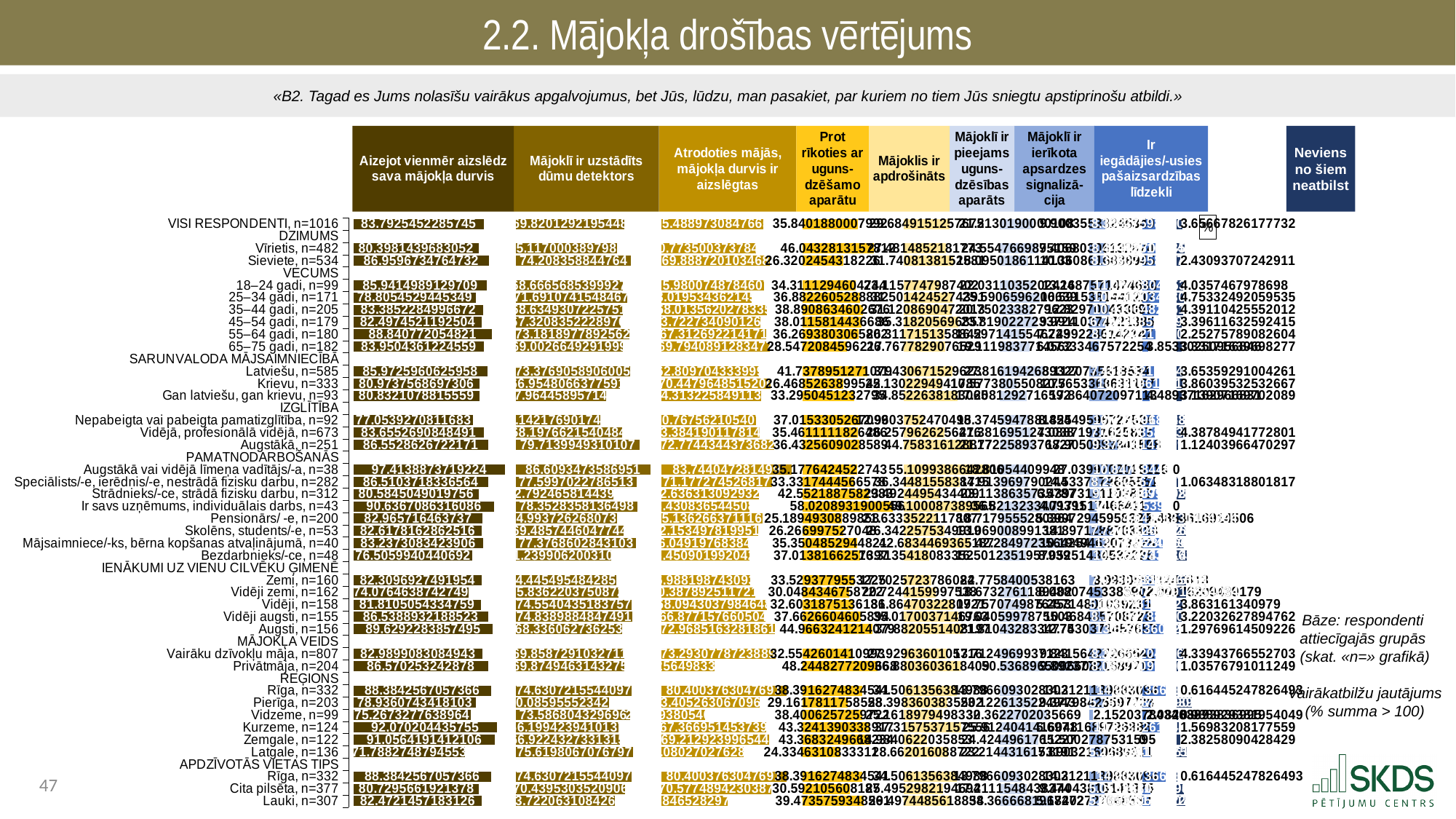
For 'Aizejot vienmēr aizslēdz sava mājokļa durvis', which is larger: Vīrietis, n=482 or Sieviete, n=534? Sieviete, n=534 What is the value of 'Aizejot vienmēr aizslēdz sava mājokļa durvis' for Sieviete, n=534? 86.9596734764732 Which category has the lowest value for 'Aizejot vienmēr aizslēdz sava mājokļa durvis'? Latgale, n=136 Which category has the highest value for 'Aizejot vienmēr aizslēdz sava mājokļa durvis'? Augstākā vai vidējā līmeņa vadītājs/-a, n=38 What kind of chart is shown on the slide? bar chart What is the value of 'Aizejot vienmēr aizslēdz sava mājokļa durvis' for Latgale, n=136? 71.7882748794553 How many groups are listed under REĢIONS? 6 What is the title of the slide's chart? % How many series does the legend list? 9 What is the value of 'Aizejot vienmēr aizslēdz sava mājokļa durvis' for VISI RESPONDENTI, n=1016? 83.7925452285745 What is the value of 'Aizejot vienmēr aizslēdz sava mājokļa durvis' for Kurzeme, n=124? 92.070204435755 Among the REĢIONS groups, which has the highest value for 'Aizejot vienmēr aizslēdz sava mājokļa durvis'? Kurzeme, n=124